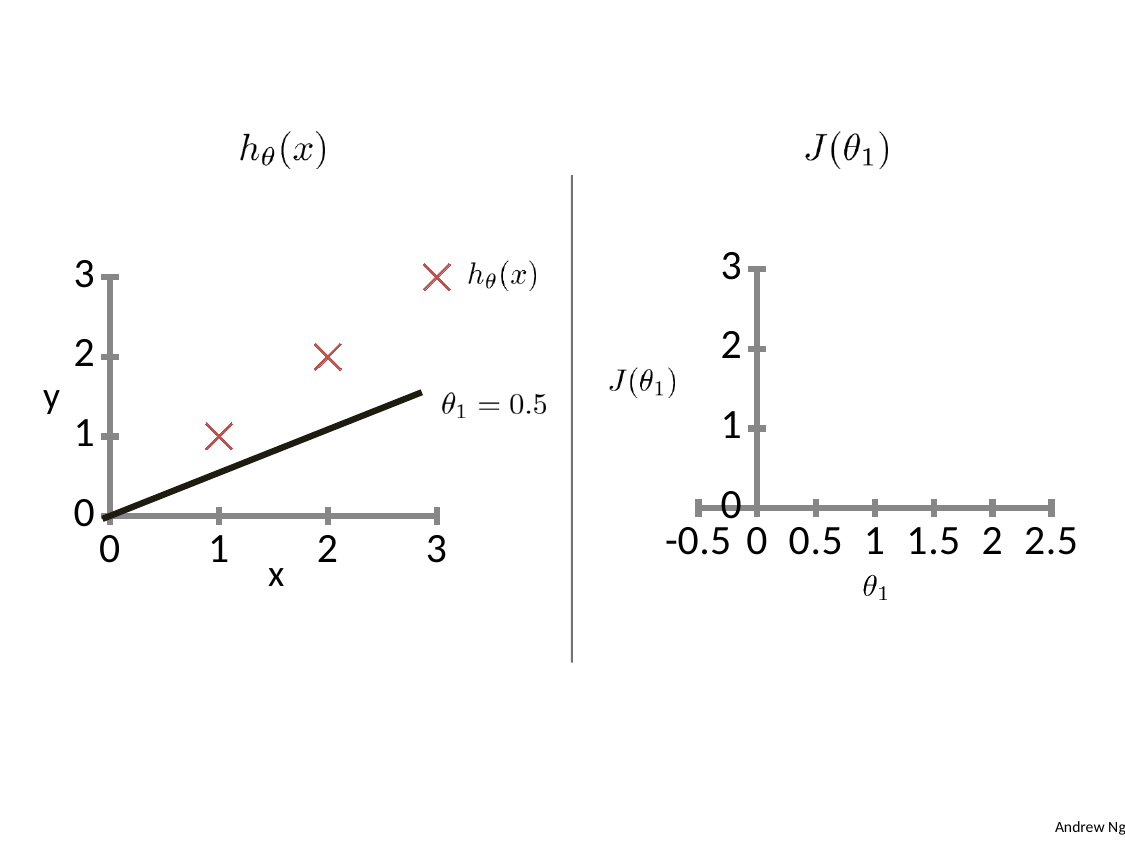
On the left chart titled h_θ(x), how many red X data points are plotted? 3 On the left chart titled h_θ(x), what is the y value of the data point at x = 2? 2 On the left chart titled h_θ(x), do the y values of the data points rise or fall as x increases? rise On the left chart titled h_θ(x), is the y value of the black line at x = 3 greater or less than 2? less On the left chart titled h_θ(x), what is the difference in y between the data points at x = 3 and x = 1? 2 On the left chart titled h_θ(x), which data point has the lowest y value? x = 1 On the left chart titled h_θ(x), which data point has the highest y value? x = 3 On the left chart titled h_θ(x), what is the y value of the data point at x = 1? 1 On the left chart titled h_θ(x), what is the y value of the data point at x = 3? 3 On the right chart titled J(θ1), what is the label of the horizontal axis? θ1 On the left chart titled h_θ(x), what is the highest value shown on the y axis? 3 On the left chart titled h_θ(x), what value of θ1 is labelled next to the black line? 0.5